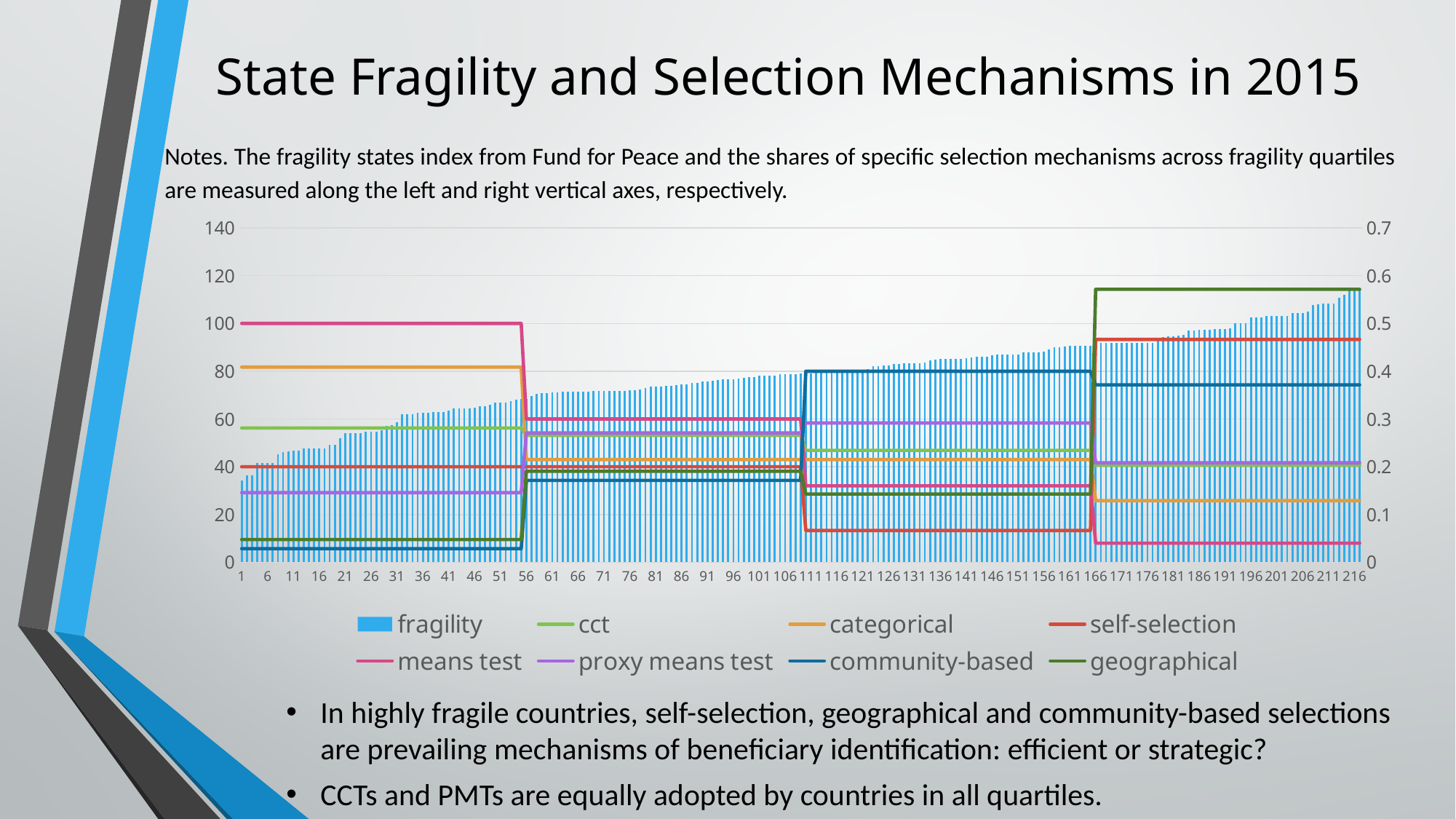
Is the fragility value at x = 216 greater or less than 100 on the left axis? greater Is the means test share in the last fragility quartile (x = 166 to 216) greater or less than 0.1 on the right axis? less How many series does the legend list? 8 Which selection mechanism has the highest share in the last fragility quartile (x = 166 to 216)? geographical What kind of chart is used to plot the fragility series? bar chart Do the fragility bars rise or fall along the x axis from 1 to 216? rise In the last fragility quartile (x = 166 to 216), which is larger: the geographical share or the self-selection share? geographical What kind of chart is used to plot the selection mechanism series such as cct and means test? line chart Which selection mechanism has the highest share in the first fragility quartile (x = 1 to 55)? means test Is the means test share in the first fragility quartile (x = 1 to 55) greater or less than 0.4 on the right axis? greater